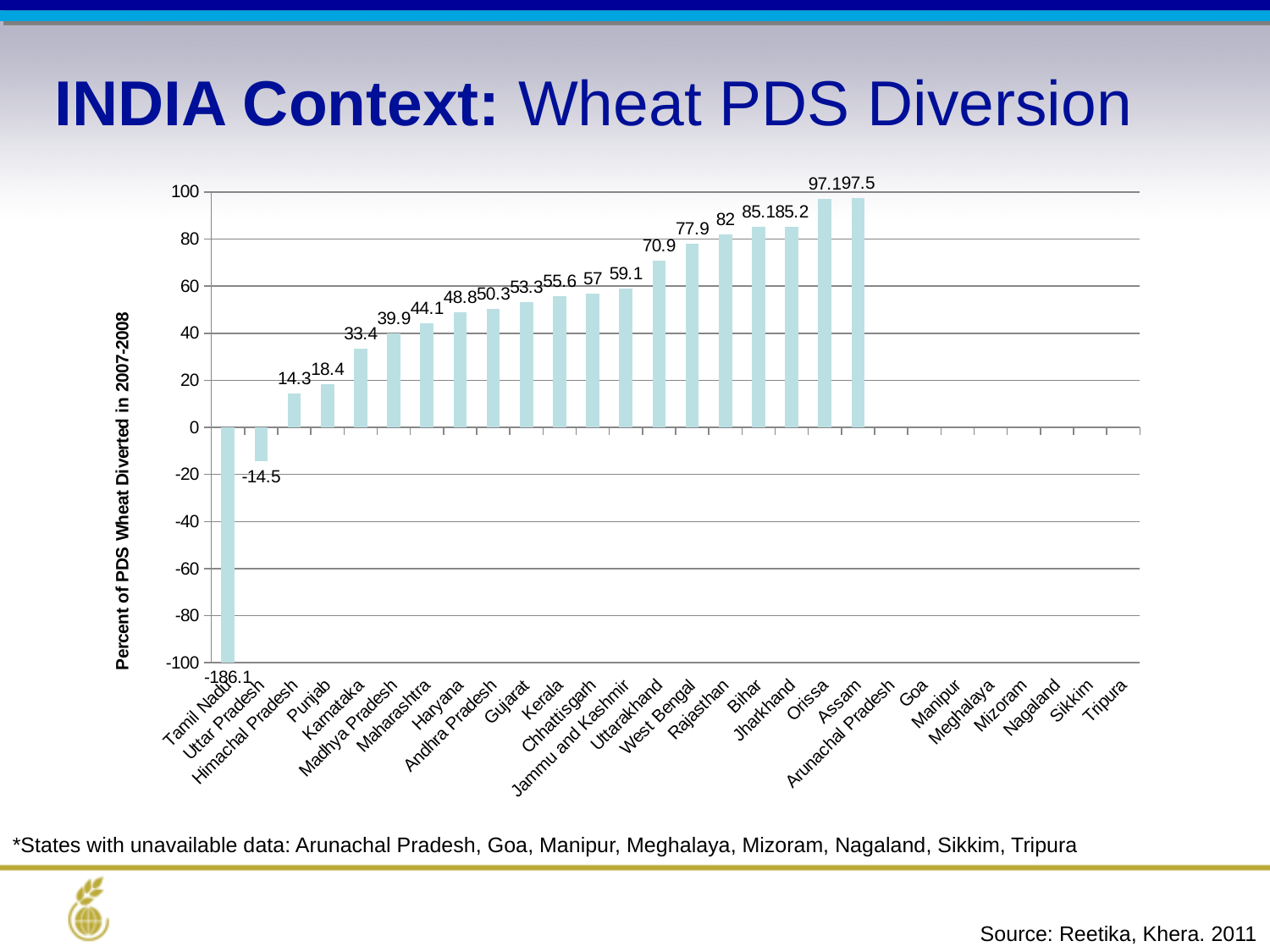
Is the value for Uttarakhand greater or less than 60? greater Which has a larger value, Punjab or Karnataka? Karnataka Which state has the highest value? Assam What is the value for Uttar Pradesh? -14.5 What is the value for Karnataka? 33.4 What is the value for Jharkhand? 85.2 What is the value for Tamil Nadu? -186.1 How many states are labelled on the x axis? 28 What kind of chart is shown? bar chart Which state has the lowest value? Tamil Nadu What is the difference between the values for Rajasthan and West Bengal? 4.1 What is the y-axis title of the chart? Percent of PDS Wheat Diverted in 2007-2008